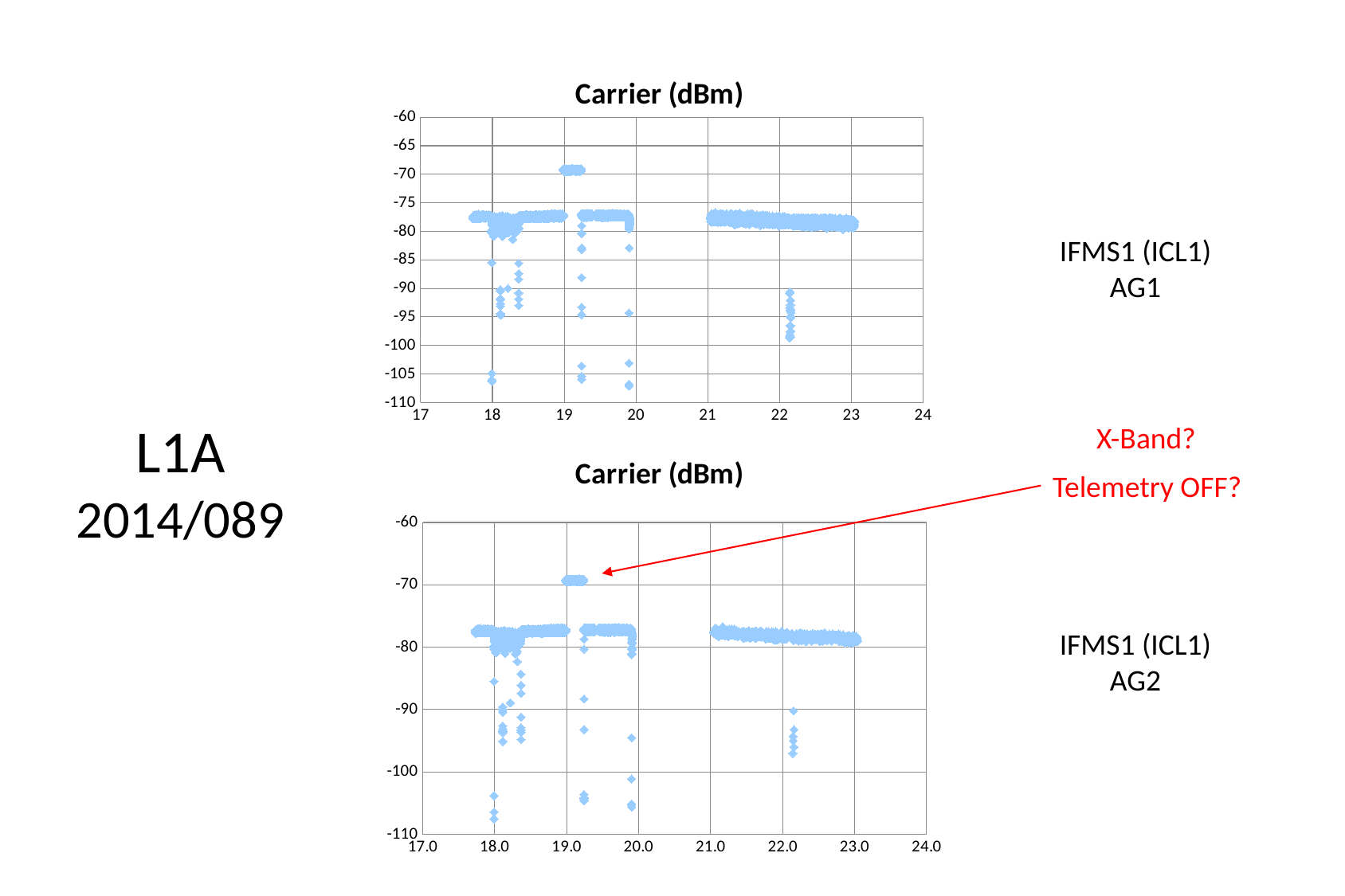
What is the title of the bottom chart on the slide? Carrier (dBm) What is the lowest value shown on the y axis of the top chart? -110 In the top chart (AG1), are the lowest points near x = 19.9 greater or less than -100? less In the bottom chart (AG2), are the isolated points near x = 22.2 greater or less than -80? less In the top chart (AG1), is the value of the cluster of points just after x = 19 greater or less than -75? greater What kind of chart is the top chart on the slide? scatter chart